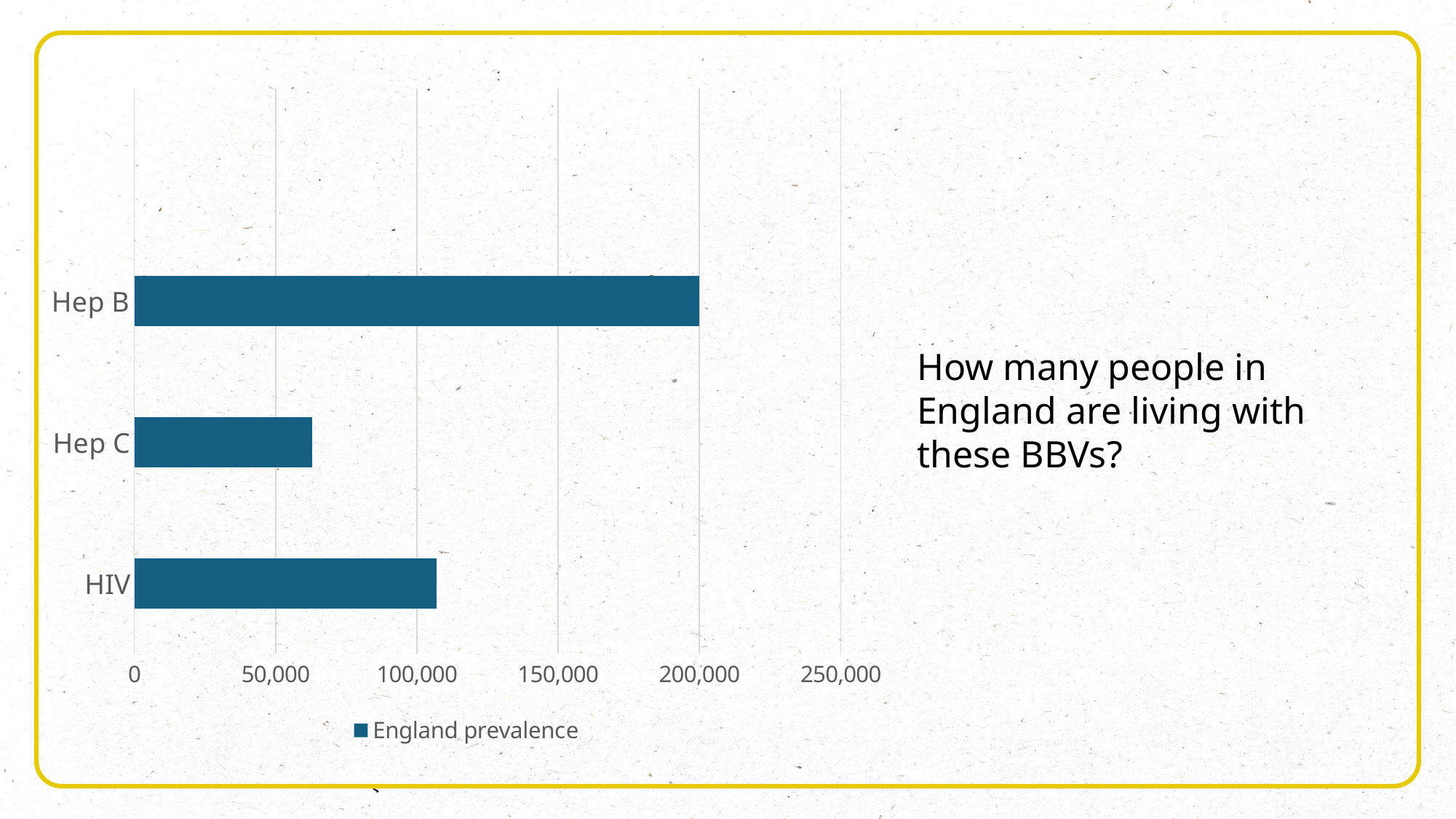
How many series does the legend list? 1 How many categories are plotted in the chart? 3 What is the name of the series shown in the legend? England prevalence Is the value for HIV greater or less than 100,000? greater Is the value for Hep C greater or less than 100,000? less Is the value for Hep C greater or less than 50,000? greater What is the England prevalence value for Hep B? 200,000 Which category has the lowest England prevalence? Hep C What type of chart is shown on the slide? bar chart Which category has the highest England prevalence? Hep B Which has a larger England prevalence, HIV or Hep C? HIV